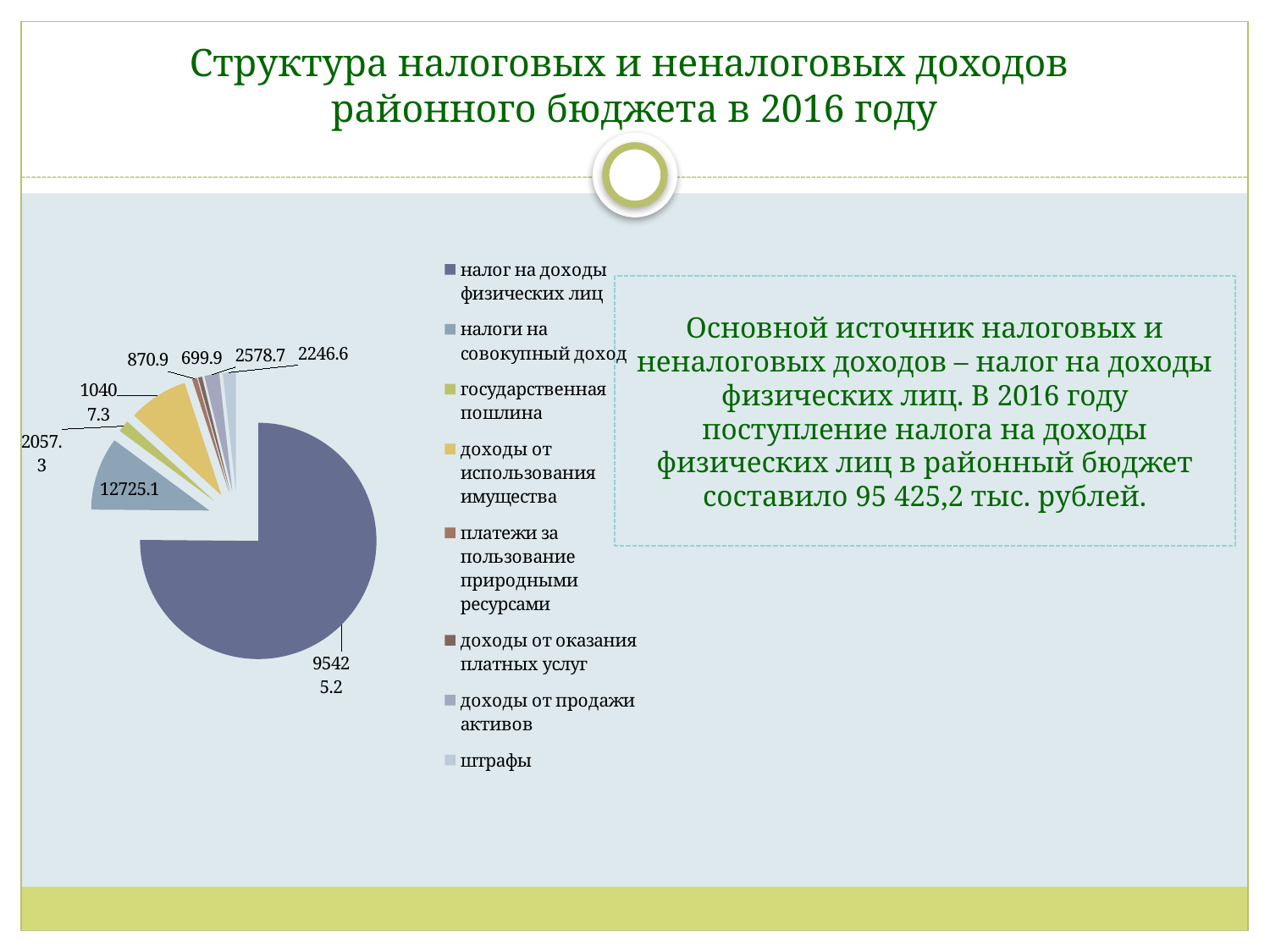
What is the difference between the values for налог на доходы физических лиц and налоги на совокупный доход? 82700.1 What is the value shown for доходы от использования имущества? 10407.3 Which is larger: платежи за пользование природными ресурсами or государственная пошлина? государственная пошлина What is the value shown for доходы от продажи активов? 2578.7 How many categories does the pie chart's legend list? 8 What is the title of the slide containing the pie chart? Структура налоговых и неналоговых доходов районного бюджета в 2016 году What kind of chart is shown on the slide? pie chart What is the value shown for налоги на совокупный доход? 12725.1 Which category has the largest slice of the pie? налог на доходы физических лиц Which category has the smallest value in the pie chart? доходы от оказания платных услуг What is the value shown for налог на доходы физических лиц? 95425.2 What is the value shown for штрафы? 2246.6